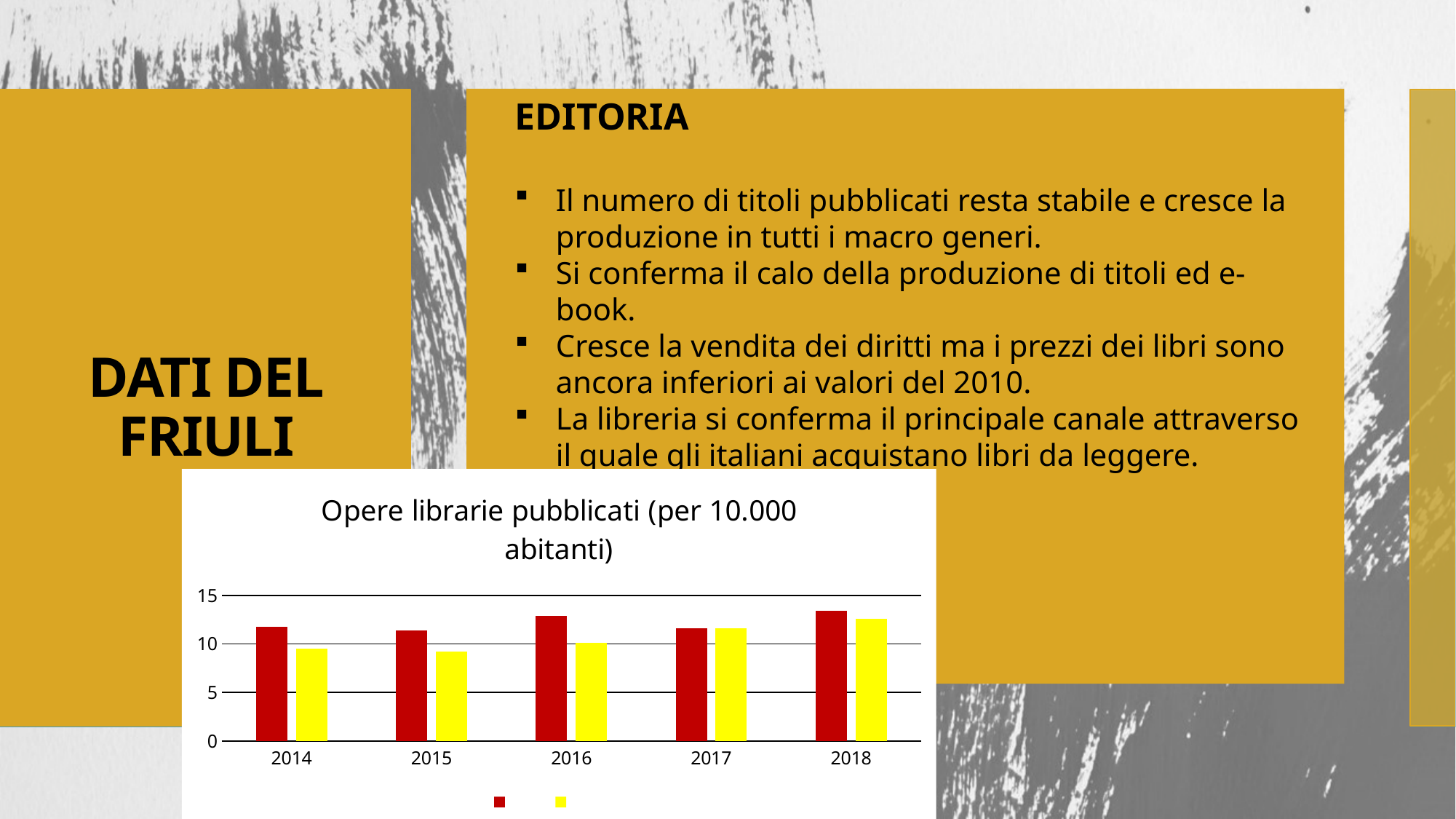
In 2014, which bar is larger, the red one or the yellow one? the red one Is the value of the red bar for 2018 greater or less than 15? less How many series does the chart's legend list? 2 How many years are shown on the x axis of the chart? 5 Is the value of the yellow bar for 2018 greater or less than 10? greater In which year is the yellow bar the highest? 2018 What is the title of the chart? Opere librarie pubblicati (per 10.000 abitanti) Is the value of the red bar for 2014 greater or less than 10? greater What kind of chart is shown on the slide? bar chart Do the yellow bars generally rise or fall from 2014 to 2018? rise